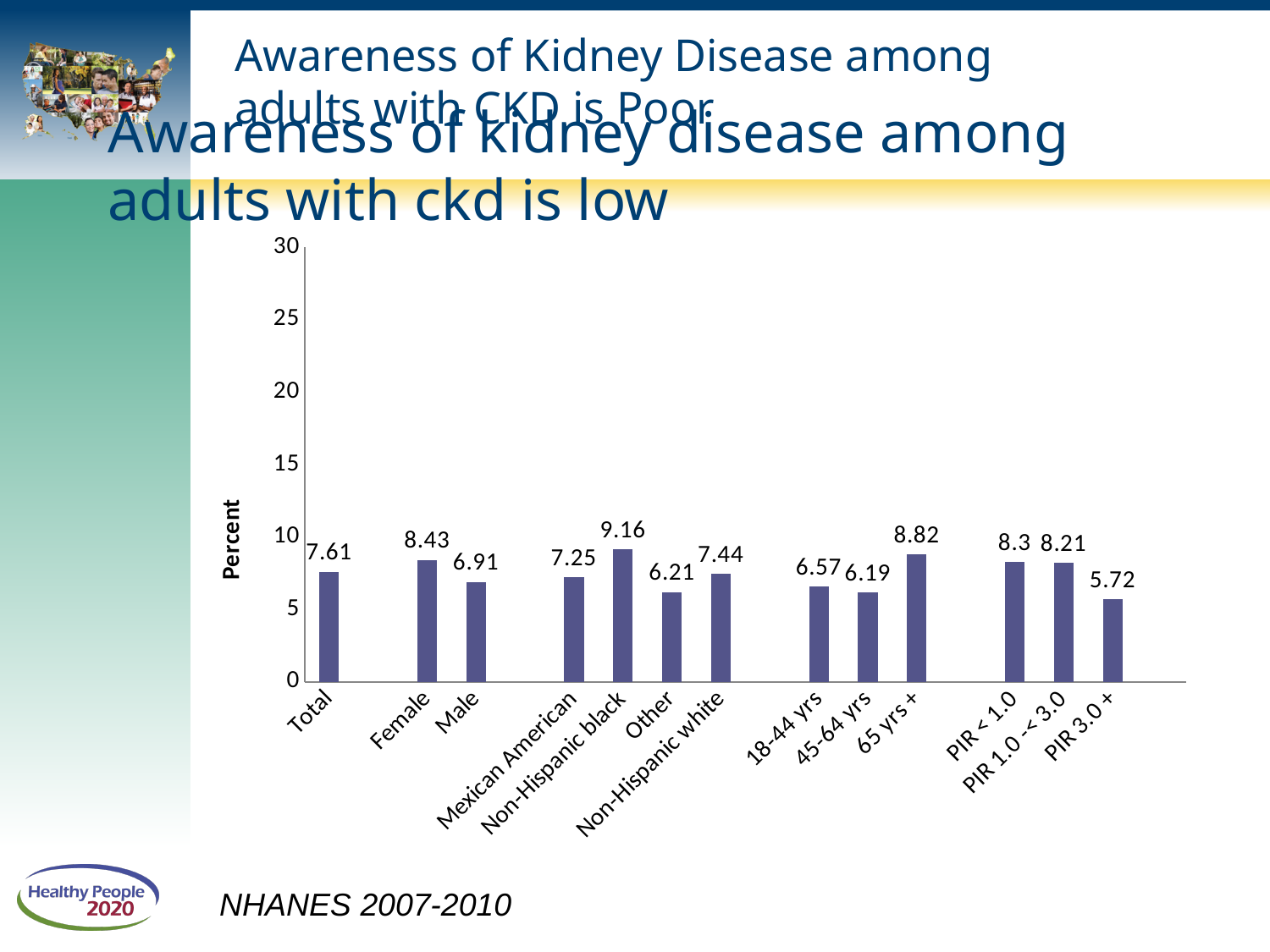
Is the value for Total greater or less than 10? less What is the difference between the values for Female and Male? 1.52 What kind of chart is shown on the slide? bar chart Which category has the lowest value? PIR 3.0 + What is the value for 45-64 yrs? 6.19 What is the value for PIR 3.0 +? 5.72 Which category has the highest value? Non-Hispanic black What is the value for Total? 7.61 How many categories are shown on the x axis? 13 Which is larger, the value for Female or the value for Male? Female What is the difference between the values for 65 yrs + and 18-44 yrs? 2.25 What is the value for Non-Hispanic black? 9.16